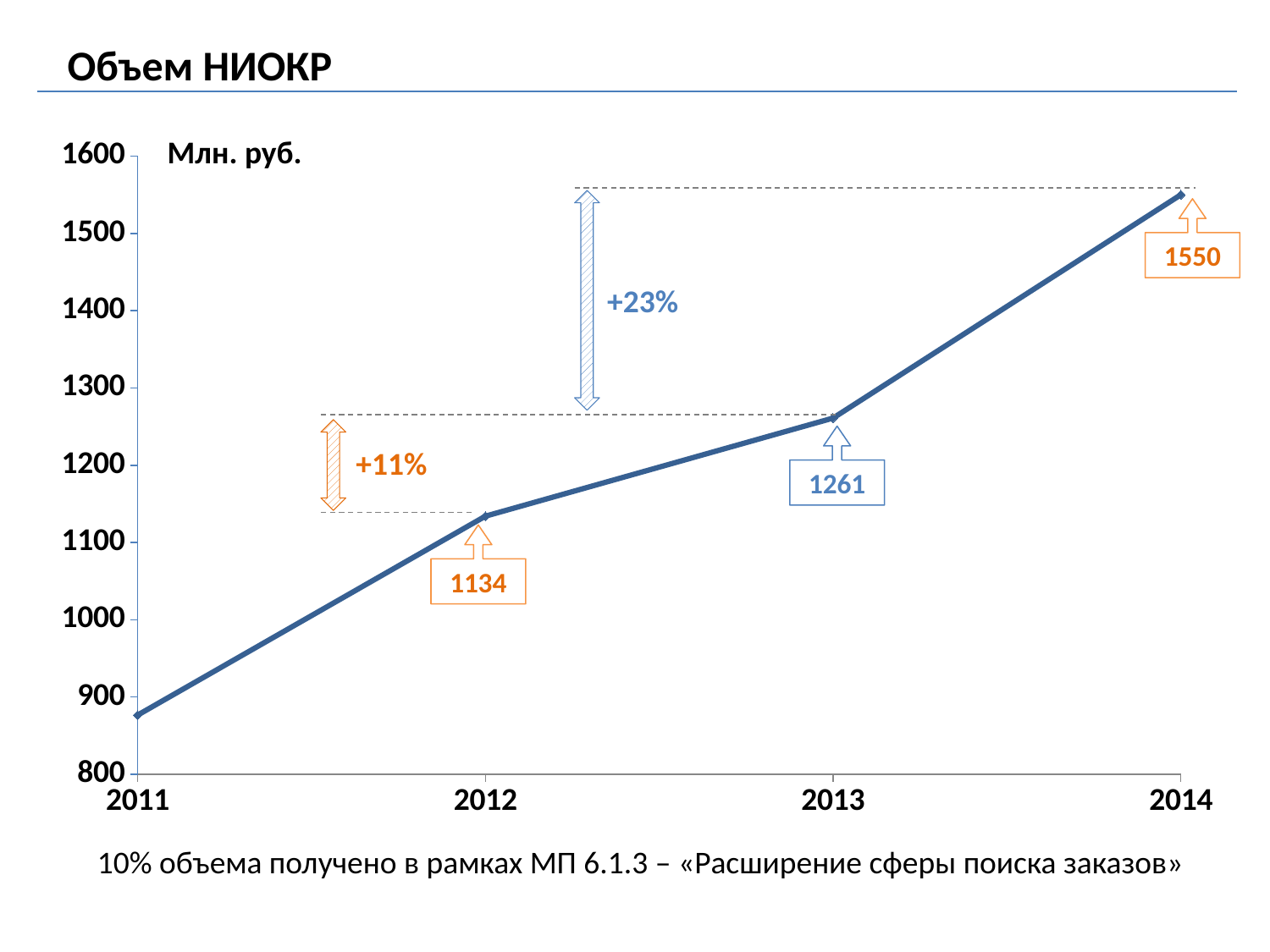
What is the difference between the values for 2013 and 2012? 127 How many years are plotted on the chart? 4 What kind of chart is shown on the slide? line chart Do the values rise or fall from 2011 to 2014? rise What is the value for 2014? 1550 What is the value for 2012? 1134 Is the value for 2011 greater or less than 900? less Which is larger, the value for 2012 or the value for 2013? 2013 Which year has the lowest value? 2011 Which year has the highest value? 2014 What is the difference between the values for 2014 and 2013? 289 What is the value for 2013? 1261